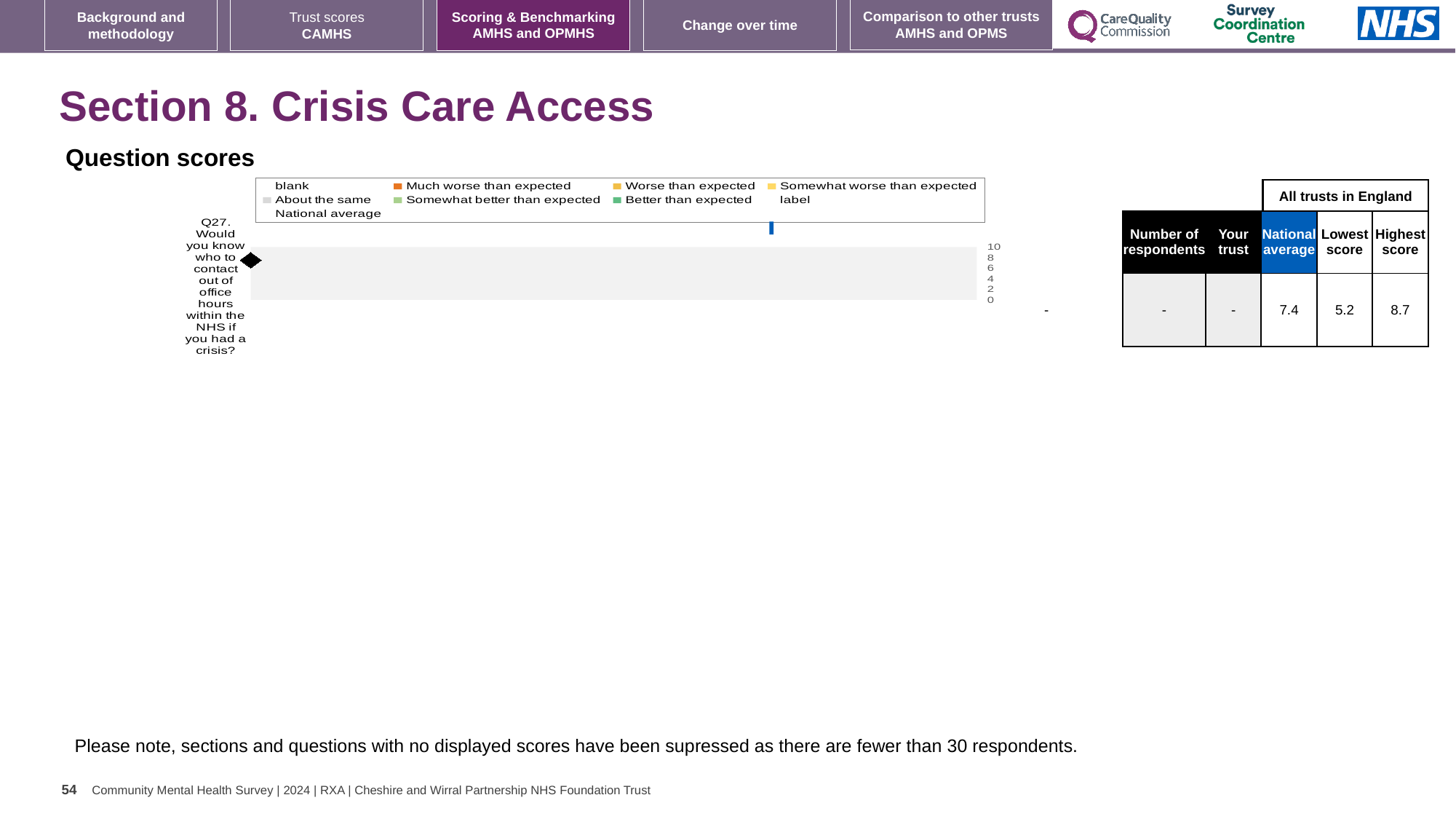
What is the highest value shown on the chart's horizontal axis? 10 In the 'All trusts in England' table, what is the Lowest score for Q27? 5.2 What is the difference between the Highest score and the Lowest score shown in the table for Q27? 3.5 Which question number is shown on the chart's vertical axis? Q27 Is the National average for Q27 in the table larger or smaller than the Highest score? smaller What kind of chart is shown under 'Question scores'? bar chart What value is shown for 'Your trust' in the table for Q27? - In the 'All trusts in England' table, what is the National average score for Q27? 7.4 In the 'All trusts in England' table, what is the Highest score for Q27? 8.7 How many questions (categories) are listed on the chart's vertical axis? 1